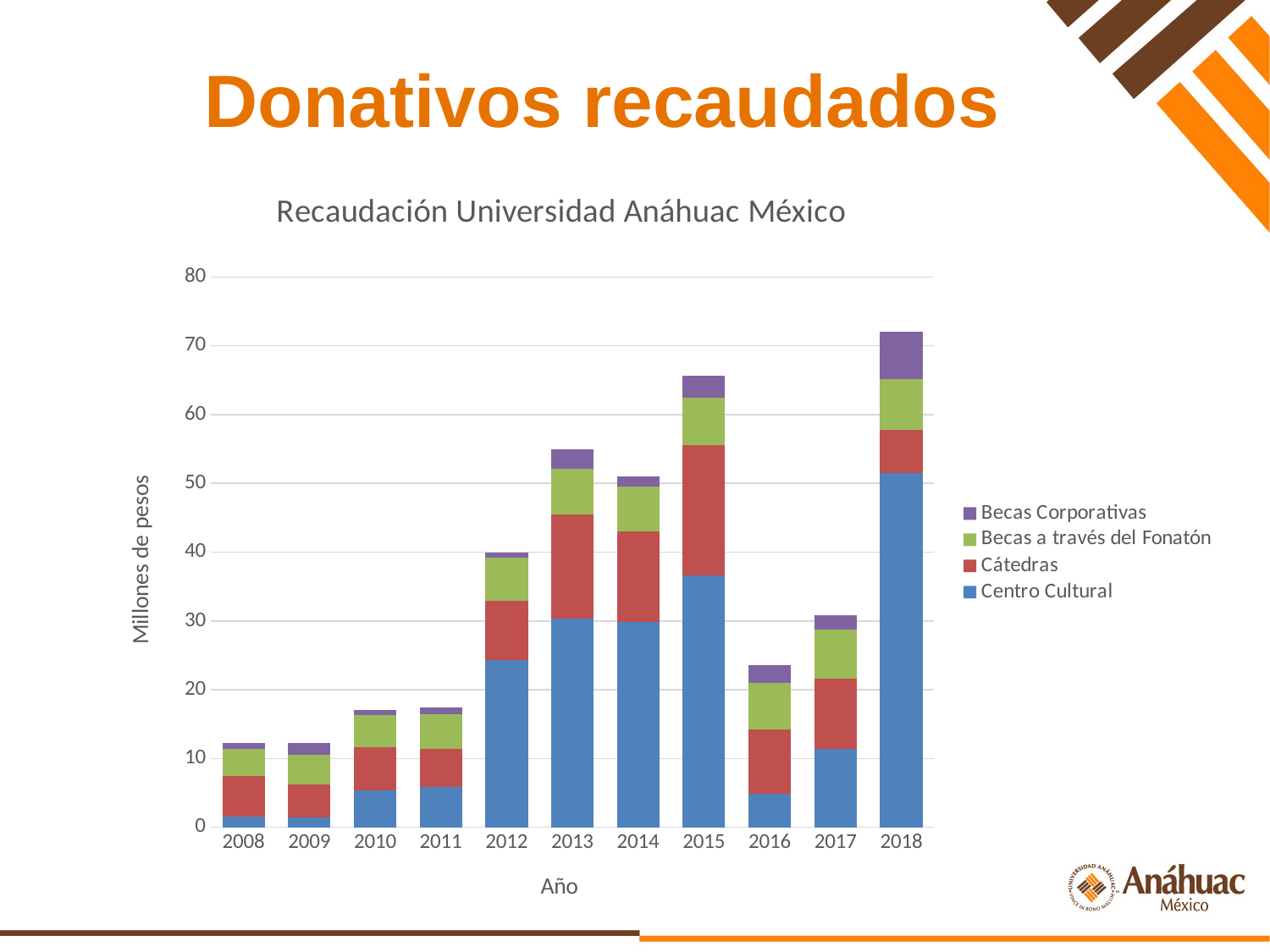
Which year has the larger total, 2014 or 2015? 2015 What kind of chart is shown on the slide? Stacked bar chart How many series does the legend list? 4 What is the title of the chart? Recaudación Universidad Anáhuac México Is the total for 2016 greater or less than 30? less Is the total for 2018 greater or less than 60? greater Do the total values rise or fall from 2008 to 2013? rise Which year has the highest total stacked bar? 2018 Is the total for 2013 greater or less than 50? greater What is the label of the vertical axis? Millones de pesos How many years are shown on the x axis? 11